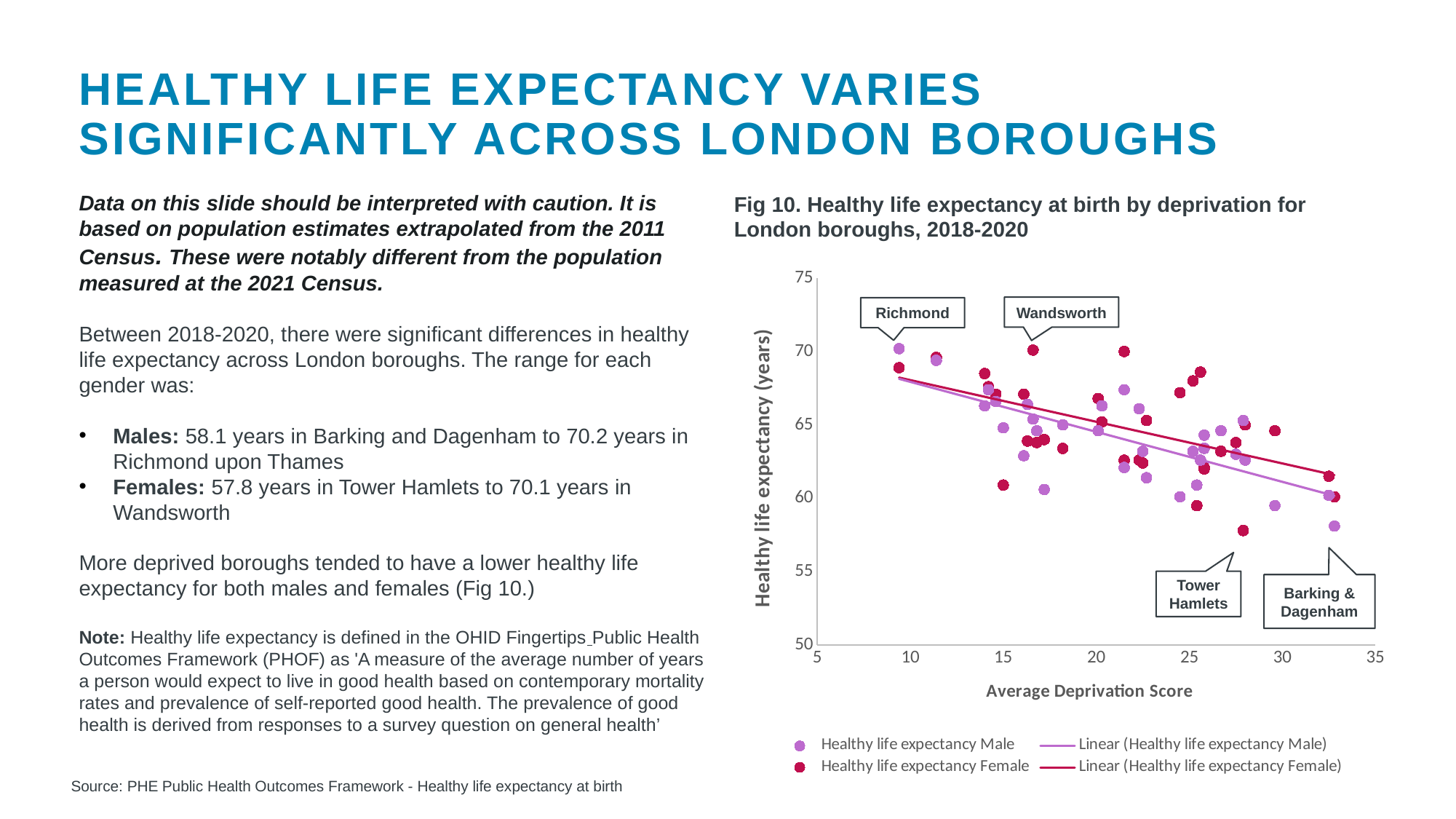
In Fig 10, is the male healthy life expectancy point labelled Barking & Dagenham greater or less than 60 years? less Which borough has the lowest female healthy life expectancy in Fig 10? Tower Hamlets What kind of chart is Fig 10? Scatter chart What is the difference between the highest and lowest male healthy life expectancy values given on the slide? 12.1 years In Fig 10, is the female healthy life expectancy point labelled Tower Hamlets greater or less than 60 years? less In Fig 10, is the male healthy life expectancy point labelled Richmond greater or less than 65 years? greater What is the title of the x axis in Fig 10? Average Deprivation Score In Fig 10, do healthy life expectancy values rise or fall as the average deprivation score increases? Fall How many entries does the legend of Fig 10 list? 4 In Fig 10, which is higher: the female healthy life expectancy point labelled Wandsworth or the one labelled Tower Hamlets? Wandsworth Which borough has the highest male healthy life expectancy in Fig 10? Richmond upon Thames What is the male healthy life expectancy for Richmond upon Thames shown on the slide? 70.2 years